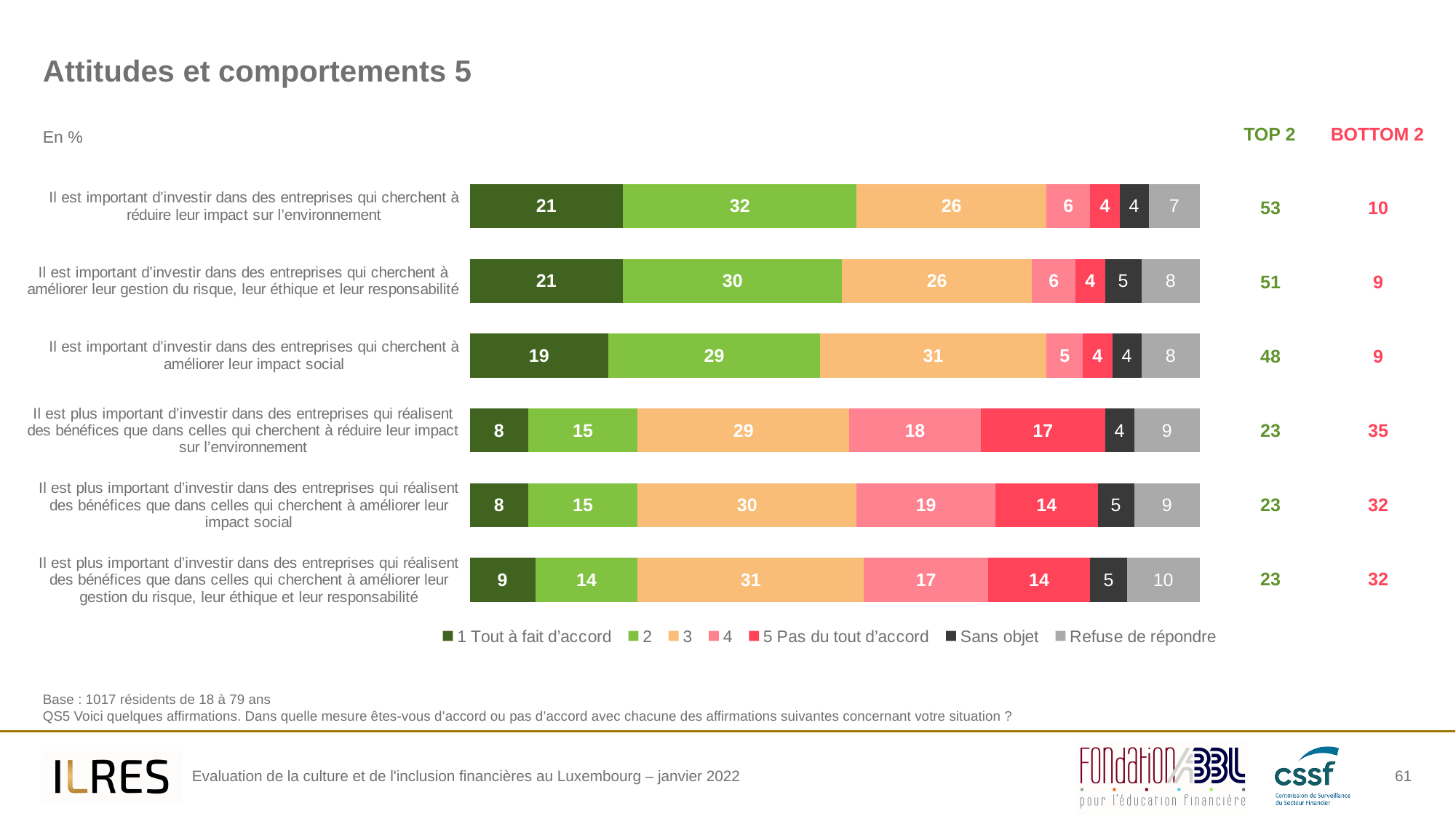
Which statement has the highest value for the series '2'? Il est important d'investir dans des entreprises qui cherchent à réduire leur impact sur l'environnement Which has the larger 'Refuse de répondre' value: the statement about 'réduire leur impact sur l'environnement' (important) or the statement about 'réalisent des bénéfices ... améliorer leur gestion du risque, leur éthique et leur responsabilité'? Il est plus important d'investir dans des entreprises qui réalisent des bénéfices que dans celles qui cherchent à améliorer leur gestion du risque, leur éthique et leur responsabilité What is the value of '5 Pas du tout d'accord' for the statement 'Il est plus important d'investir dans des entreprises qui réalisent des bénéfices que dans celles qui cherchent à réduire leur impact sur l'environnement'? 17 What kind of chart is shown on the slide? Stacked bar chart How many series does the chart legend list? 7 What is the difference between the '3' value for 'Il est important d'investir dans des entreprises qui cherchent à améliorer leur impact social' (31) and for 'Il est important d'investir dans des entreprises qui cherchent à réduire leur impact sur l'environnement' (26)? 5 What is the total of the stacked bar for 'Il est important d'investir dans des entreprises qui cherchent à réduire leur impact sur l'environnement'? 100 What is the value of '1 Tout à fait d'accord' for the statement 'Il est important d'investir dans des entreprises qui cherchent à réduire leur impact sur l'environnement'? 21 Which legend entry is shown in the darkest green colour? 1 Tout à fait d'accord What is the 'Sans objet' value for the statement 'Il est important d'investir dans des entreprises qui cherchent à améliorer leur gestion du risque, leur éthique et leur responsabilité'? 5 Which statement has the lowest value for the series '2'? Il est plus important d'investir dans des entreprises qui réalisent des bénéfices que dans celles qui cherchent à améliorer leur gestion du risque, leur éthique et leur responsabilité How many statements (bars) are plotted in the chart? 6